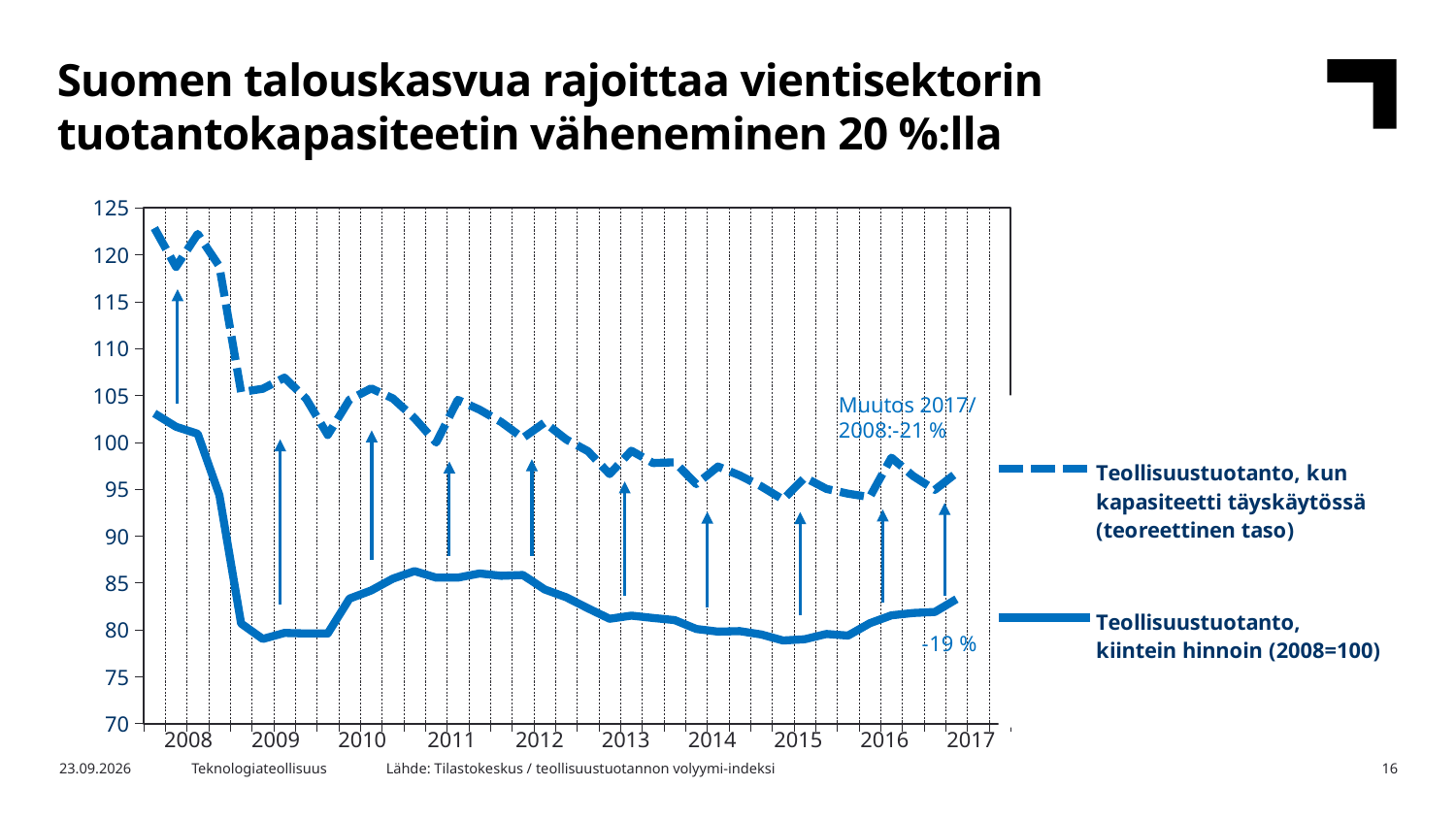
Is the value of the solid line (Teollisuustuotanto, kiintein hinnoin) in 2009 greater or less than 85? less What percentage change is annotated next to the solid line (Teollisuustuotanto, kiintein hinnoin) at the end of the series? -19 % What change from 2008 to 2017 is annotated for the dashed line (Teollisuustuotanto, kun kapasiteetti täyskäytössä)? -21 % Does the solid line (Teollisuustuotanto, kiintein hinnoin) overall rise or fall from 2008 to 2017? fall In 2012, which series is higher: the dashed line (kapasiteetti täyskäytössä) or the solid line (kiintein hinnoin)? the dashed line (kapasiteetti täyskäytössä) In which year does the solid line (Teollisuustuotanto, kiintein hinnoin) reach its highest value? 2008 Is the value of the dashed line (Teollisuustuotanto, kun kapasiteetti täyskäytössä) in 2017 greater or less than 100? less What kind of chart is shown on the slide? line chart How many years are labelled on the x axis? 10 What is the base year given in the legend for the solid line index (=100)? 2008 Is the value of the dashed line (Teollisuustuotanto, kun kapasiteetti täyskäytössä) at the start of 2008 greater or less than 120? greater How many series does the legend list? 2